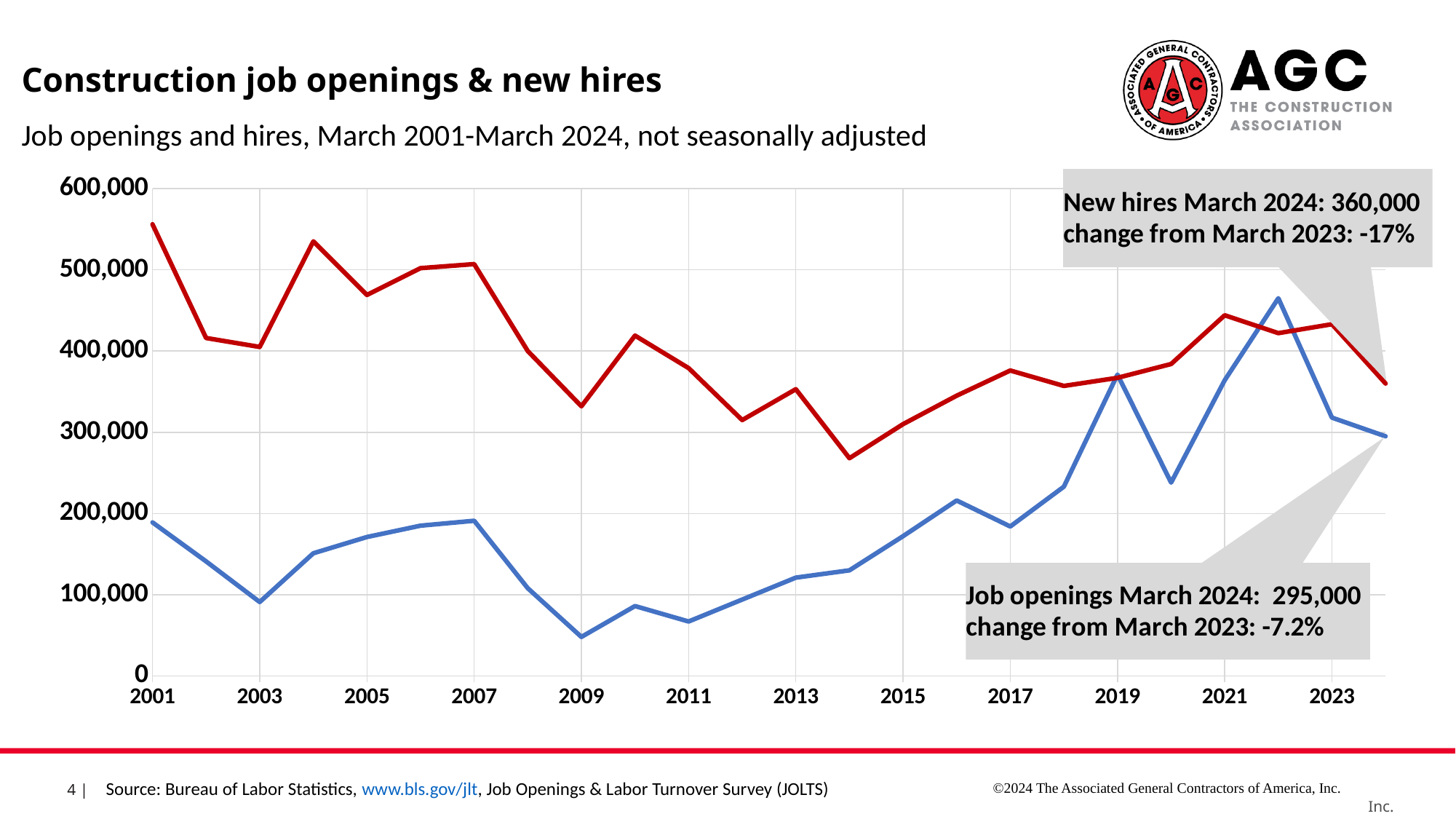
Do job openings rise or fall from 2019 to 2020? fall What is the difference between new hires and job openings in March 2024? 65,000 What is the change in job openings from March 2023 to March 2024? -7.2% What is the change in new hires from March 2023 to March 2024? -17% In which year do new hires reach their lowest value? 2014 What kind of chart is shown on the slide? line chart What is the value of new hires in March 2024? 360,000 Is the value for job openings in 2009 greater or less than 100,000? less What is the value of job openings in March 2024? 295,000 Is the value for new hires in 2001 greater or less than 500,000? greater In which year do job openings reach their highest value? 2022 In March 2024, which is larger: new hires or job openings? new hires